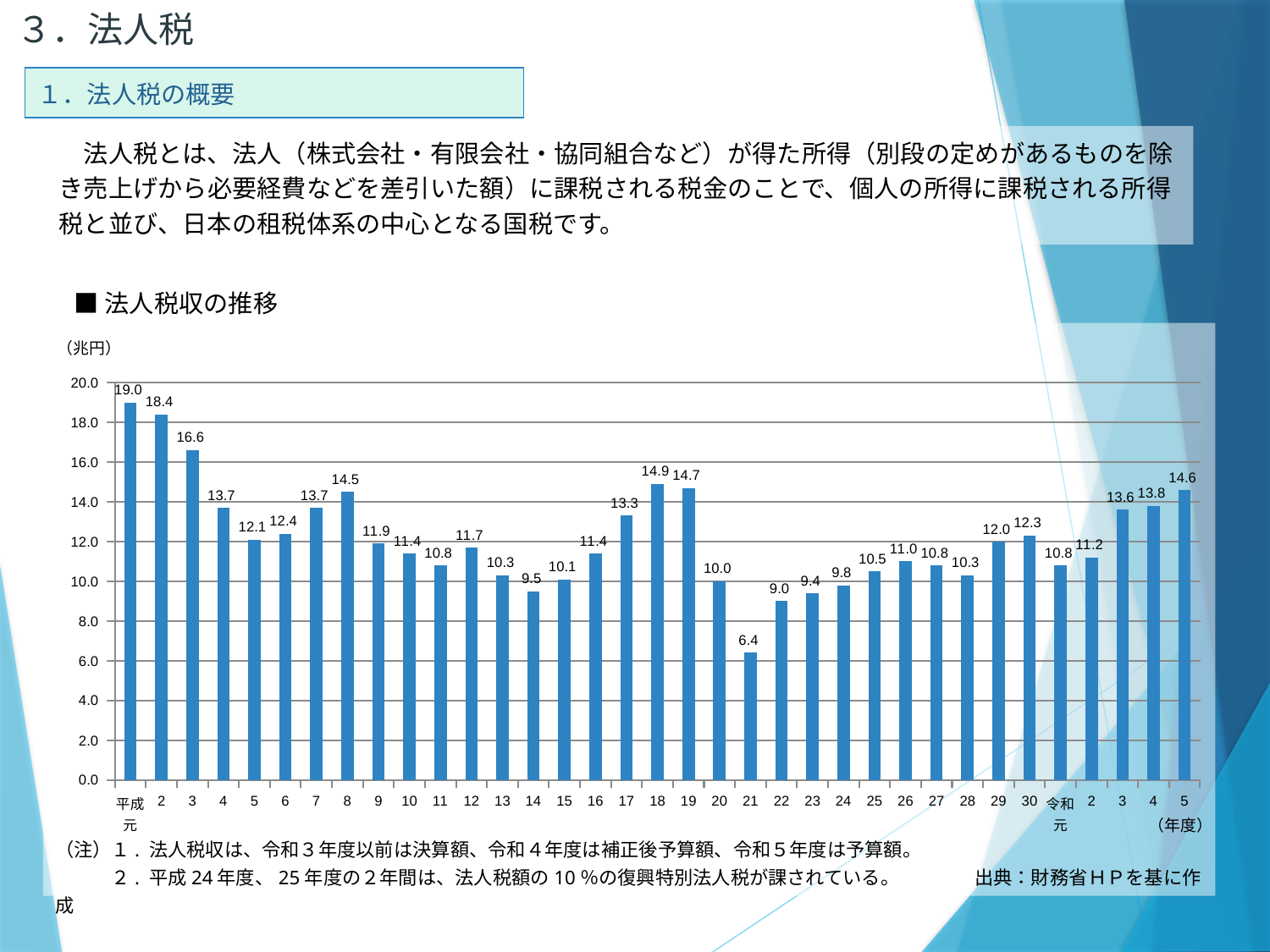
「法人税収の推移」のグラフで、平成14年度の値は10.0より大きいですか、小さいですか。 小さい 「法人税収の推移」のグラフで、平成元年度の法人税収はいくらですか。 19.0 「法人税収の推移」のグラフで、法人税収が最も低い年度はどれですか。 平成21年度 「法人税収の推移」のグラフで、平成21年度の値はいくらですか。 6.4 「法人税収の推移」のグラフで、令和元年度から令和5年度にかけて法人税収は増加していますか、減少していますか。 増加 「法人税収の推移」のグラフで、平成30年度と令和元年度では、どちらの法人税収が大きいですか。 平成30年度 「法人税収の推移」のグラフで、平成18年度と平成20年度の値の差はいくらですか。 4.9 「法人税収の推移」のグラフはどの種類のグラフですか。 棒グラフ 「法人税収の推移」のグラフで、令和5年度の法人税収はいくらですか。 14.6 「法人税収の推移」のグラフの縦軸の単位は何ですか。 兆円 「法人税収の推移」のグラフには、何年度分の棒がありますか。 35 「法人税収の推移」のグラフで、法人税収が最も高い年度はどれですか。 平成元年度